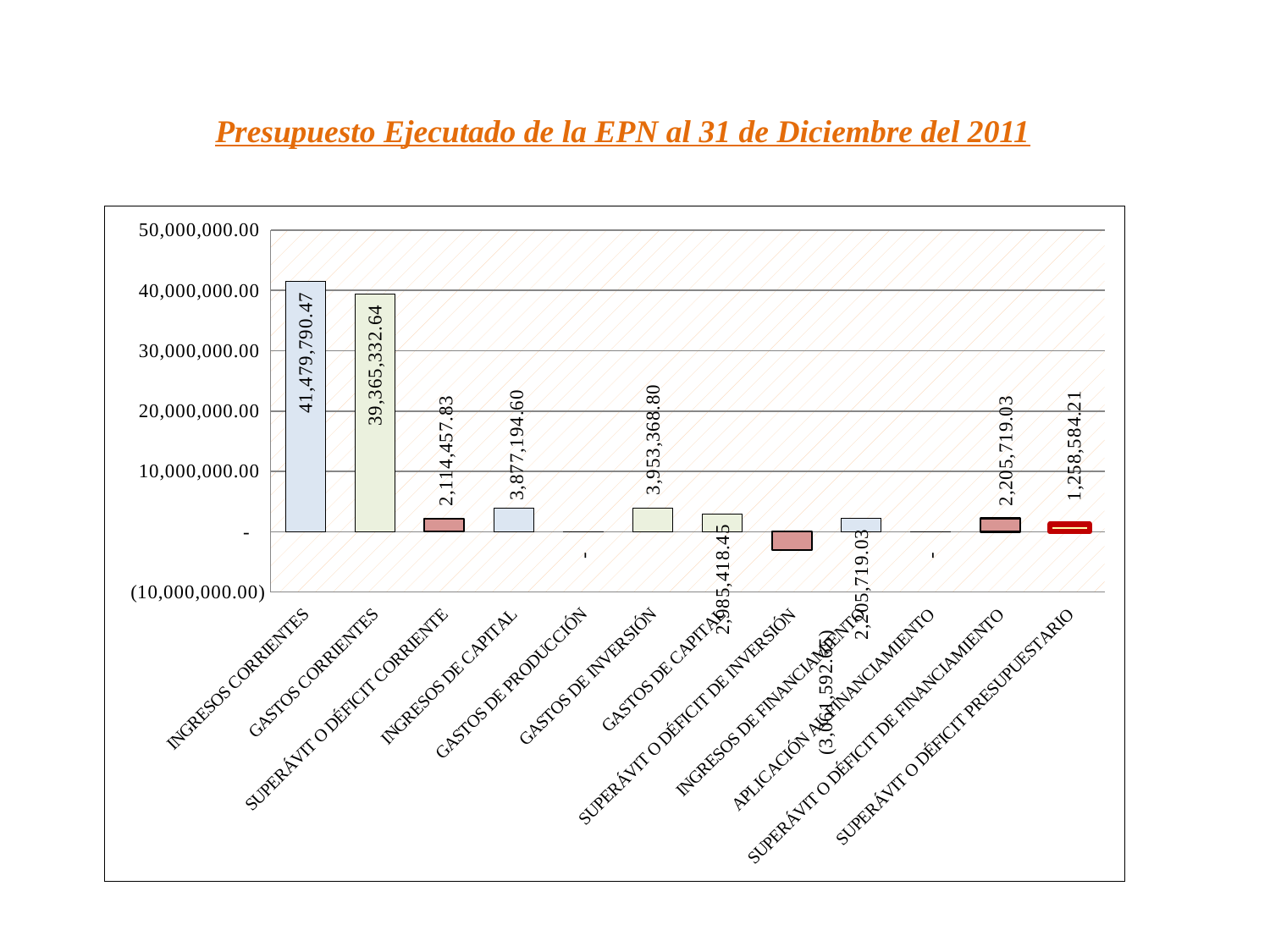
What is the value for GASTOS CORRIENTES? 39,365,332.64 What is the value for INGRESOS CORRIENTES? 41,479,790.47 Is the value for GASTOS CORRIENTES greater or less than 40,000,000.00? less Which category has the highest value? INGRESOS CORRIENTES What kind of chart is shown on the slide? bar chart Which is larger, GASTOS DE INVERSIÓN or INGRESOS DE CAPITAL? GASTOS DE INVERSIÓN What is the value for SUPERÁVIT O DÉFICIT PRESUPUESTARIO? 1,258,584.21 What is the value for GASTOS DE INVERSIÓN? 3,953,368.80 What is the difference between INGRESOS CORRIENTES and GASTOS CORRIENTES? 2,114,457.83 Which category has the lowest value? SUPERÁVIT O DÉFICIT DE INVERSIÓN How many categories are shown on the x axis? 12 What is the value for SUPERÁVIT O DÉFICIT CORRIENTE? 2,114,457.83